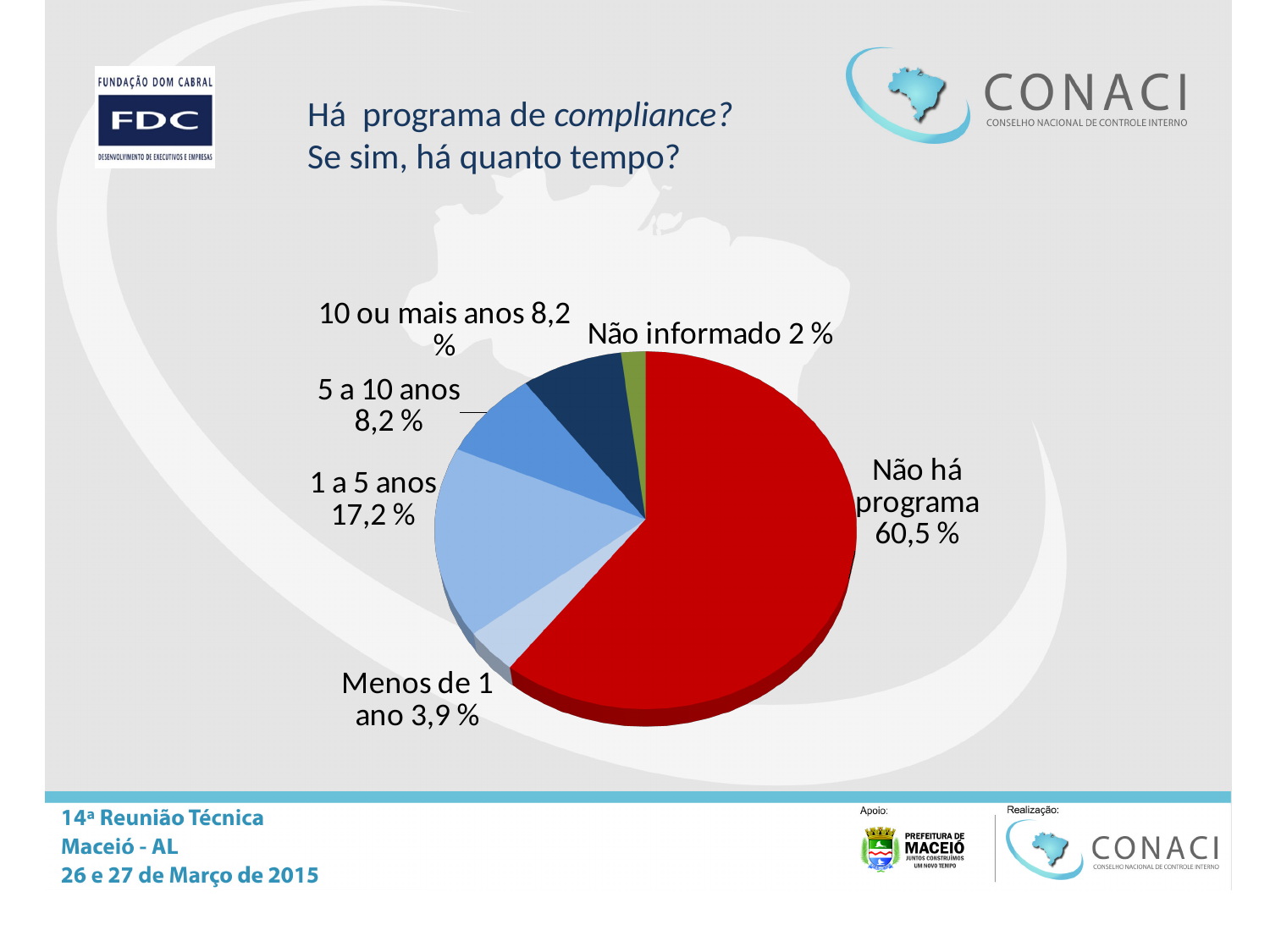
What is the combined share of the slices "Menos de 1 ano", "1 a 5 anos", "5 a 10 anos" and "10 ou mais anos"? 37,5 % How many slices does the pie chart have? 6 What is the value shown for "1 a 5 anos"? 17,2 % Which category has the largest slice of the pie? Não há programa What is the value shown for "Menos de 1 ano"? 3,9 % What is the value shown for "Não informado"? 2 % What is the value shown for "5 a 10 anos"? 8,2 % What is the difference between the "Não há programa" slice and the "1 a 5 anos" slice? 43,3 % What percentage of the pie is labelled "Não há programa"? 60,5 % Which category has the smallest slice of the pie? Não informado Which is larger, the slice for "1 a 5 anos" or the slice for "5 a 10 anos"? 1 a 5 anos What kind of chart is shown on the slide? Pie chart